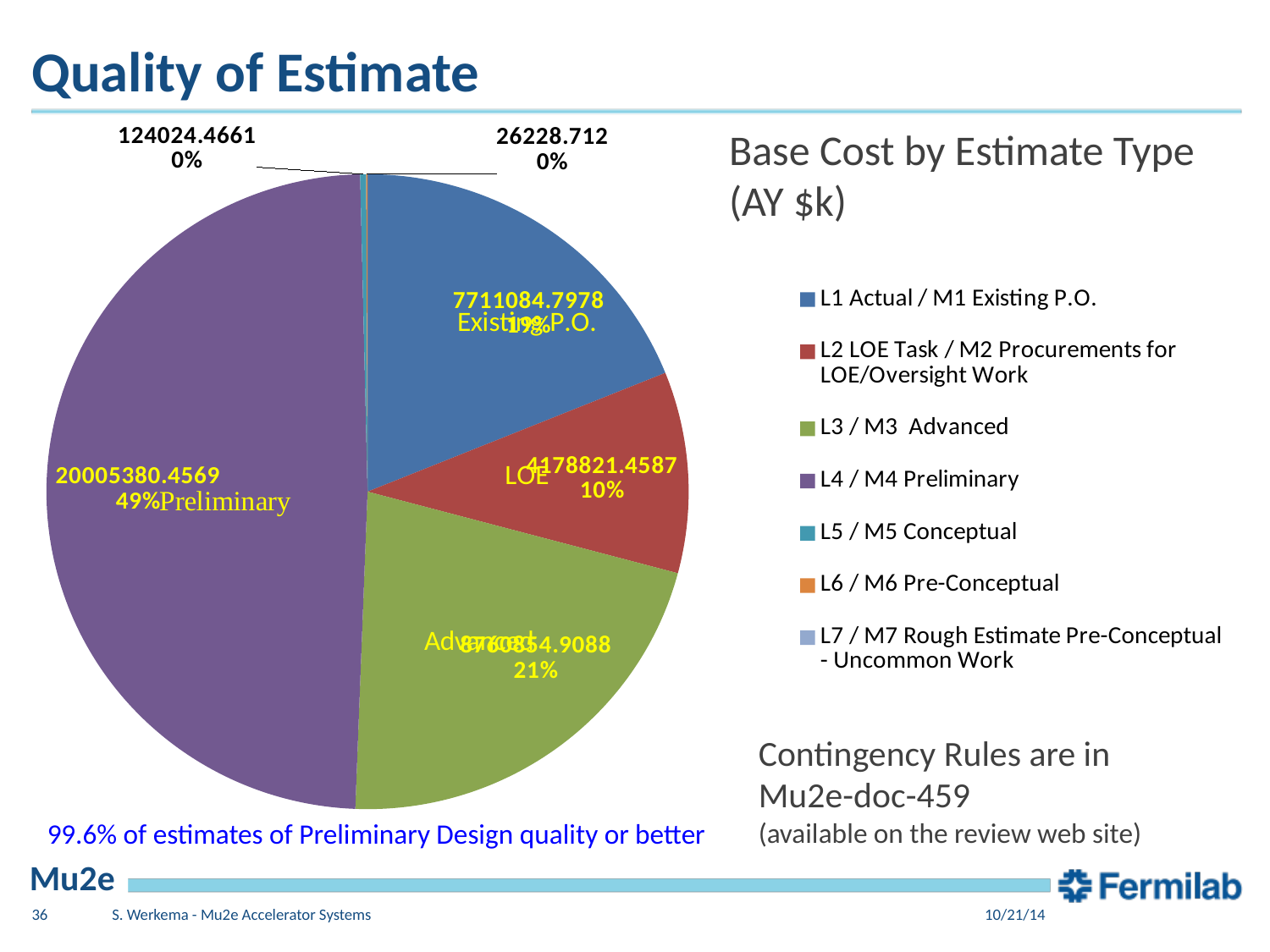
Which slice is larger, Existing P.O. or Preliminary? Preliminary What share of the pie does the Preliminary slice represent? 49% What is the value shown for the L4 / M4 Preliminary slice? 20005380.4569 What share of the pie does the L3 / M3 Advanced slice represent? 21% What kind of chart is shown on the slide? pie chart What is the value shown for the L1 Actual / M1 Existing P.O. slice? 7711084.7978 What is the value shown for the L2 LOE Task slice? 4178821.4587 What is the title of the chart? Base Cost by Estimate Type (AY $k) How many entries does the chart legend list? 7 What share of the pie does the LOE slice represent? 10% Which slice is larger, Advanced or LOE? Advanced Which estimate type has the largest slice of the pie? L4 / M4 Preliminary